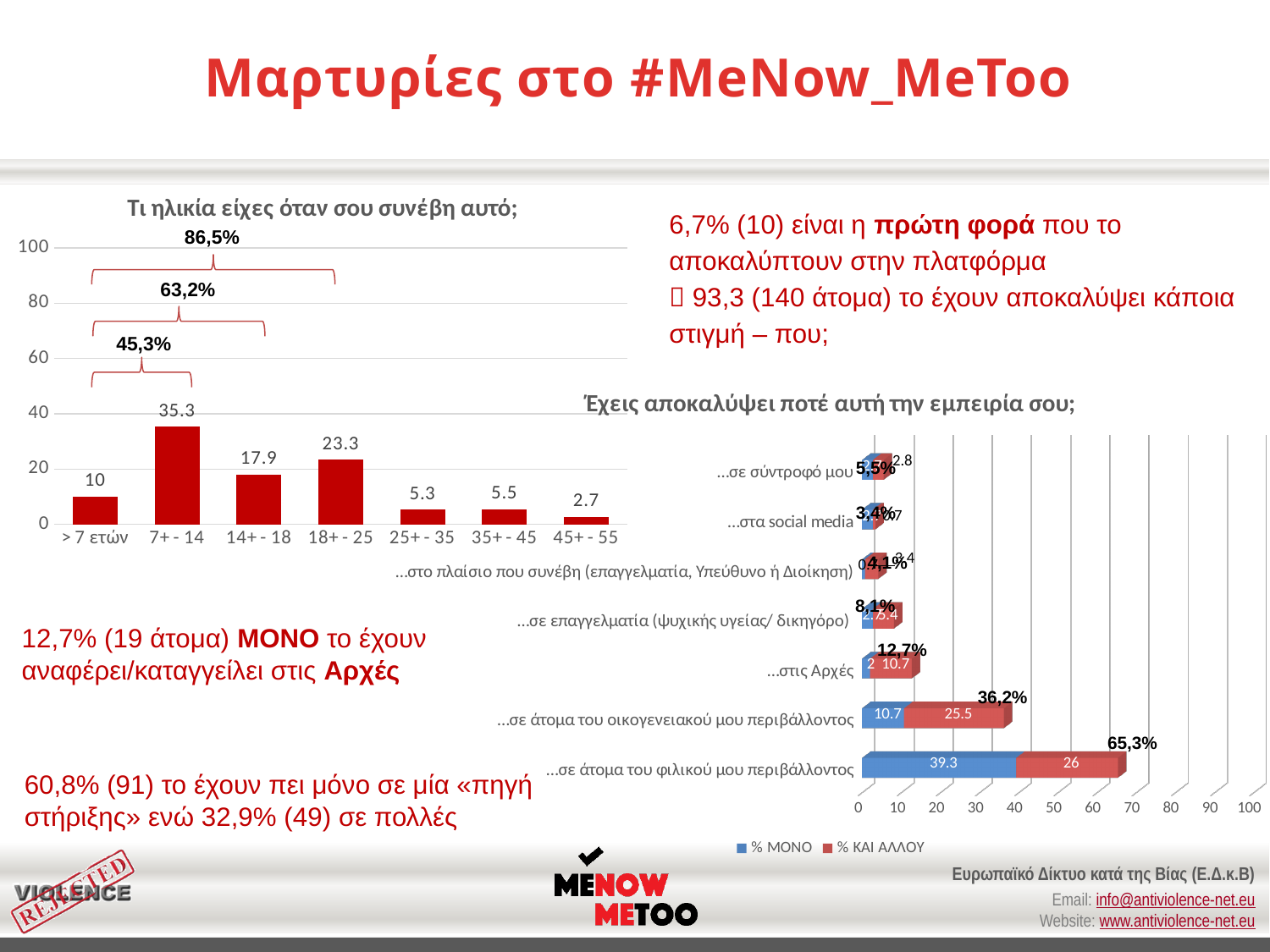
In the chart 'Έχεις αποκαλύψει ποτέ αυτή την εμπειρία σου;', which is larger: the total for '...στις Αρχές' or the total for '...σε επαγγελματία (ψυχικής υγείας/ δικηγόρο)'? ...στις Αρχές In the chart 'Τι ηλικία είχες όταν σου συνέβη αυτό;', what is the difference between the values for '18+ - 25' and '14+ - 18'? 5.4 In the chart 'Έχεις αποκαλύψει ποτέ αυτή την εμπειρία σου;', what is the total for '...σε άτομα του φιλικού μου περιβάλλοντος'? 65,3% In the chart 'Τι ηλικία είχες όταν σου συνέβη αυτό;', how many age categories are shown? 7 In the chart 'Τι ηλικία είχες όταν σου συνέβη αυτό;', which age category has the highest value? 7+ - 14 What kind of chart is 'Έχεις αποκαλύψει ποτέ αυτή την εμπειρία σου;'? Stacked bar chart In the chart 'Έχεις αποκαλύψει ποτέ αυτή την εμπειρία σου;', what is the '% ΜΟΝΟ' value for '...σε άτομα του οικογενειακού μου περιβάλλοντος'? 10.7 In the chart 'Έχεις αποκαλύψει ποτέ αυτή την εμπειρία σου;', is the total for '...σε άτομα του οικογενειακού μου περιβάλλοντος' greater or less than 40? less In the chart 'Τι ηλικία είχες όταν σου συνέβη αυτό;', which age category has the lowest value? 45+ - 55 In the chart 'Τι ηλικία είχες όταν σου συνέβη αυτό;', what is the value for the category '7+ - 14'? 35.3 In the chart 'Τι ηλικία είχες όταν σου συνέβη αυτό;', what percentage is shown by the widest bracket above the bars? 86,5% In the chart 'Έχεις αποκαλύψει ποτέ αυτή την εμπειρία σου;', how many series does the legend list? 2